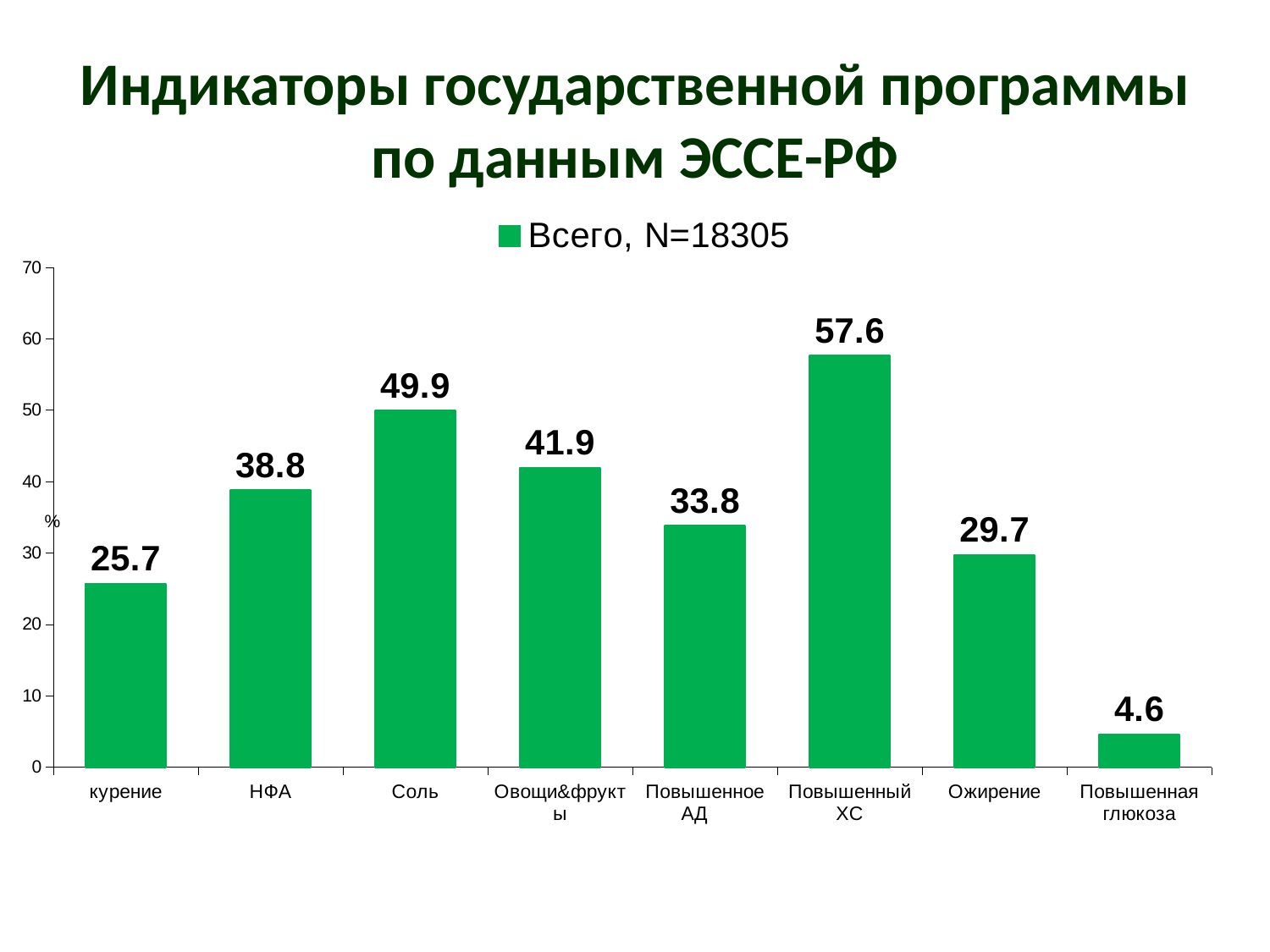
What is the value for Ожирение? 29.7 What kind of chart is shown on the slide? bar chart Which category has the highest value? Повышенный ХС What is the difference between the values for Соль and НФА? 11.1 Which is larger, the value for Овощи&фрукты or the value for Повышенное АД? Овощи&фрукты What is the value for курение? 25.7 How many series does the legend list? 1 What is the legend entry for the series? Всего, N=18305 Is the value for Соль greater or less than 40? greater What is the value for Повышенный ХС? 57.6 How many categories are shown on the x axis? 8 Which category has the lowest value? Повышенная глюкоза